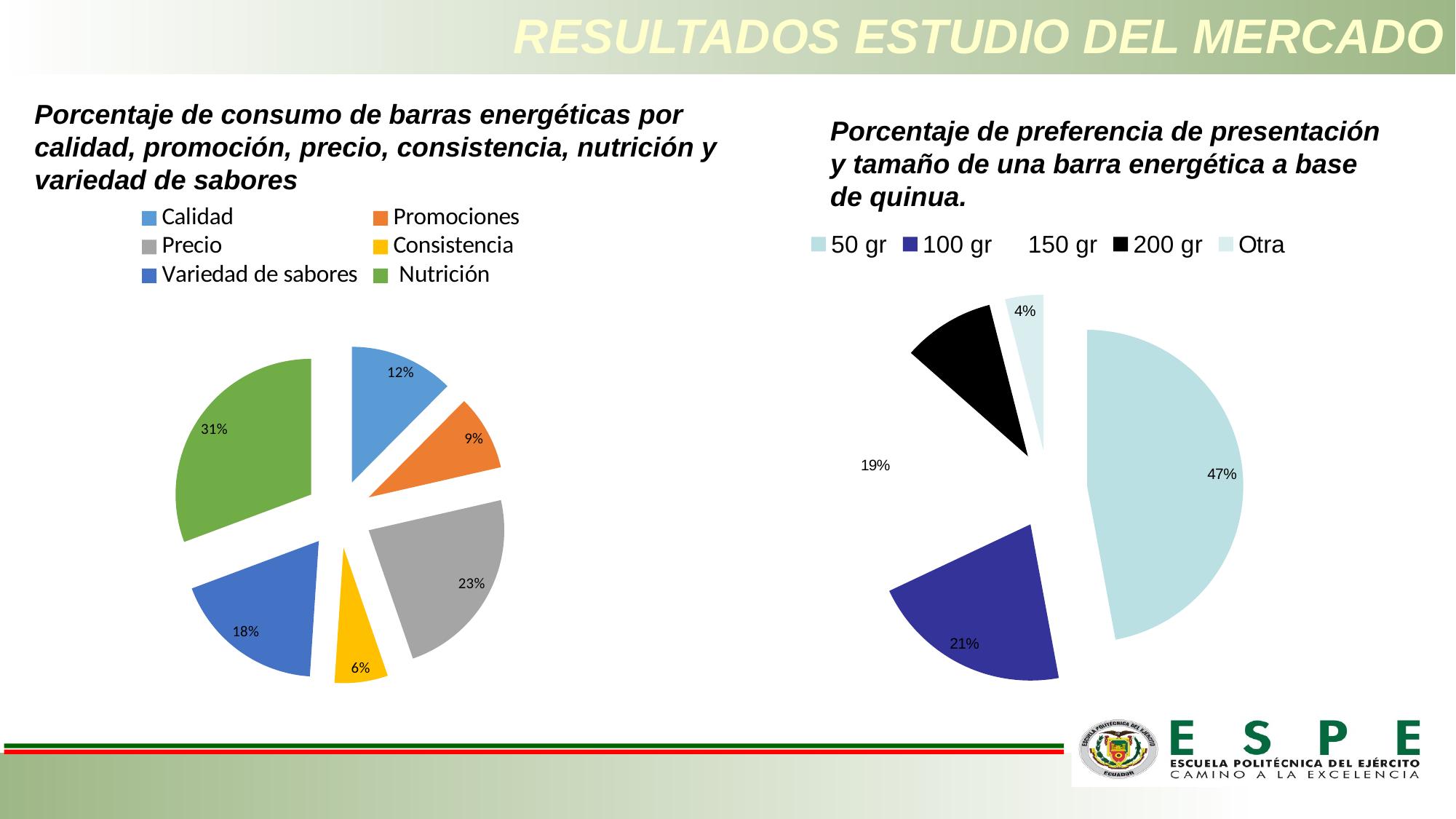
In the left pie chart (Porcentaje de consumo de barras energéticas), what percentage is shown for Consistencia? 6% In the left pie chart (Porcentaje de consumo de barras energéticas), what is the difference in percentage points between Precio and Calidad? 11 In the right pie chart (Porcentaje de preferencia de presentación y tamaño), what percentage is shown for 50 gr? 47% In the right pie chart (Porcentaje de preferencia de presentación y tamaño), what percentage is shown for 100 gr? 21% In the left pie chart (Porcentaje de consumo de barras energéticas), which category has the smallest share? Consistencia In the left pie chart (Porcentaje de consumo de barras energéticas), which category has the largest share? Nutrición What type of chart is used on the right side of the slide (Porcentaje de preferencia de presentación y tamaño)? Pie chart How many categories does the legend of the left pie chart (Porcentaje de consumo de barras energéticas) list? 6 In the left pie chart (Porcentaje de consumo de barras energéticas), which is larger, Variedad de sabores or Promociones? Variedad de sabores In the right pie chart (Porcentaje de preferencia de presentación y tamaño), which category has the largest share? 50 gr In the left pie chart (Porcentaje de consumo de barras energéticas), what percentage is shown for Nutrición? 31% In the left pie chart (Porcentaje de consumo de barras energéticas), what percentage is shown for Precio? 23%